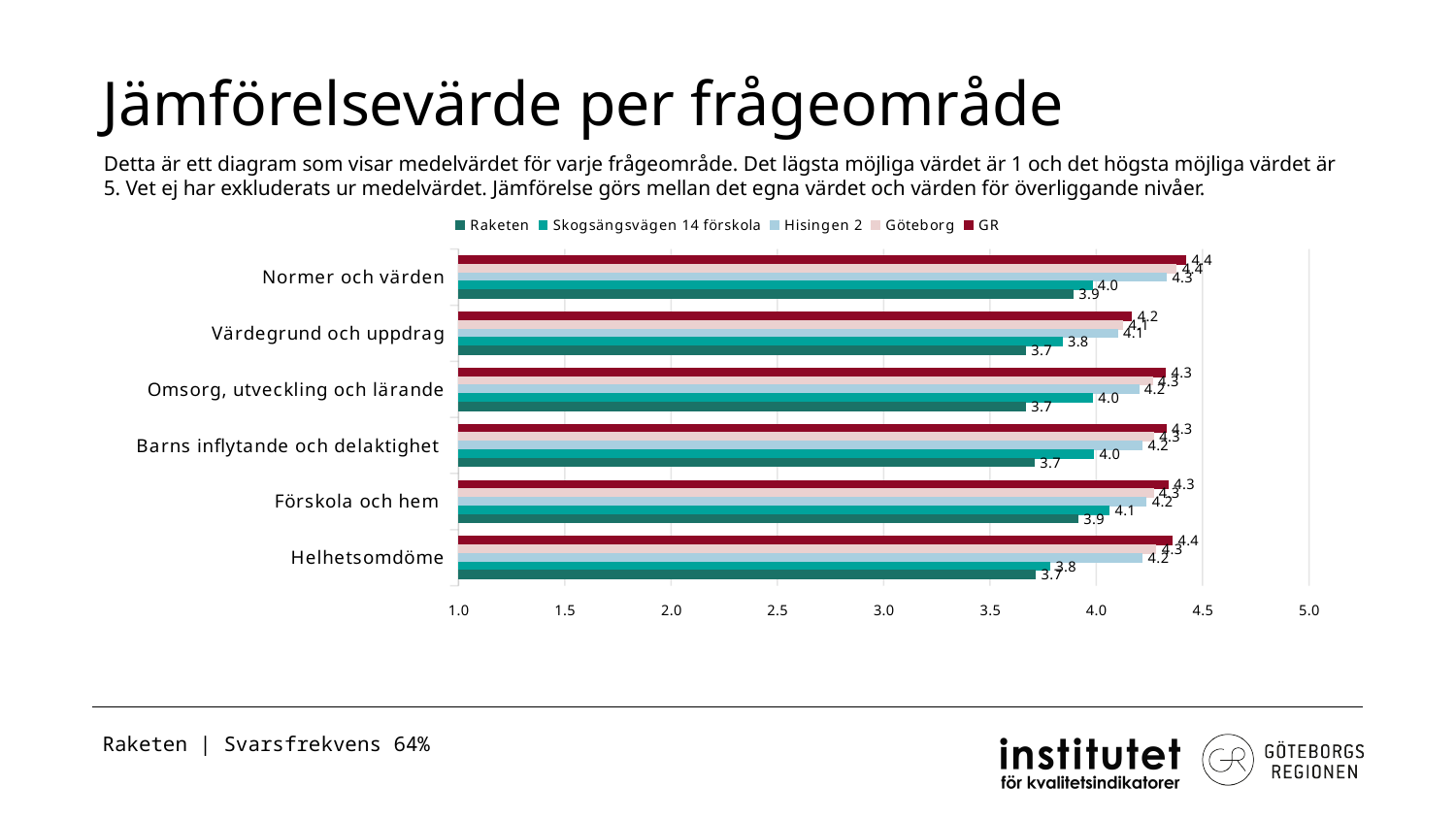
How many question areas (categories) are shown on the y axis? 6 How many series does the legend list? 5 Is the value for GR in 'Normer och värden' greater or less than 4.0? greater Which is larger in 'Omsorg, utveckling och lärande': the value for Skogsängsvägen 14 förskola or the value for Raketen? Skogsängsvägen 14 förskola What is the title of the chart? Jämförelsevärde per frågeområde What is the value for Raketen in 'Helhetsomdöme'? 3.7 What is the value for Skogsängsvägen 14 förskola in 'Förskola och hem'? 4.1 What is the difference between the GR value and the Raketen value in 'Helhetsomdöme'? 0.7 What is the value for Skogsängsvägen 14 förskola in 'Värdegrund och uppdrag'? 3.8 What type of chart is shown on the slide? bar chart What is the value for Raketen in 'Normer och värden'? 3.9